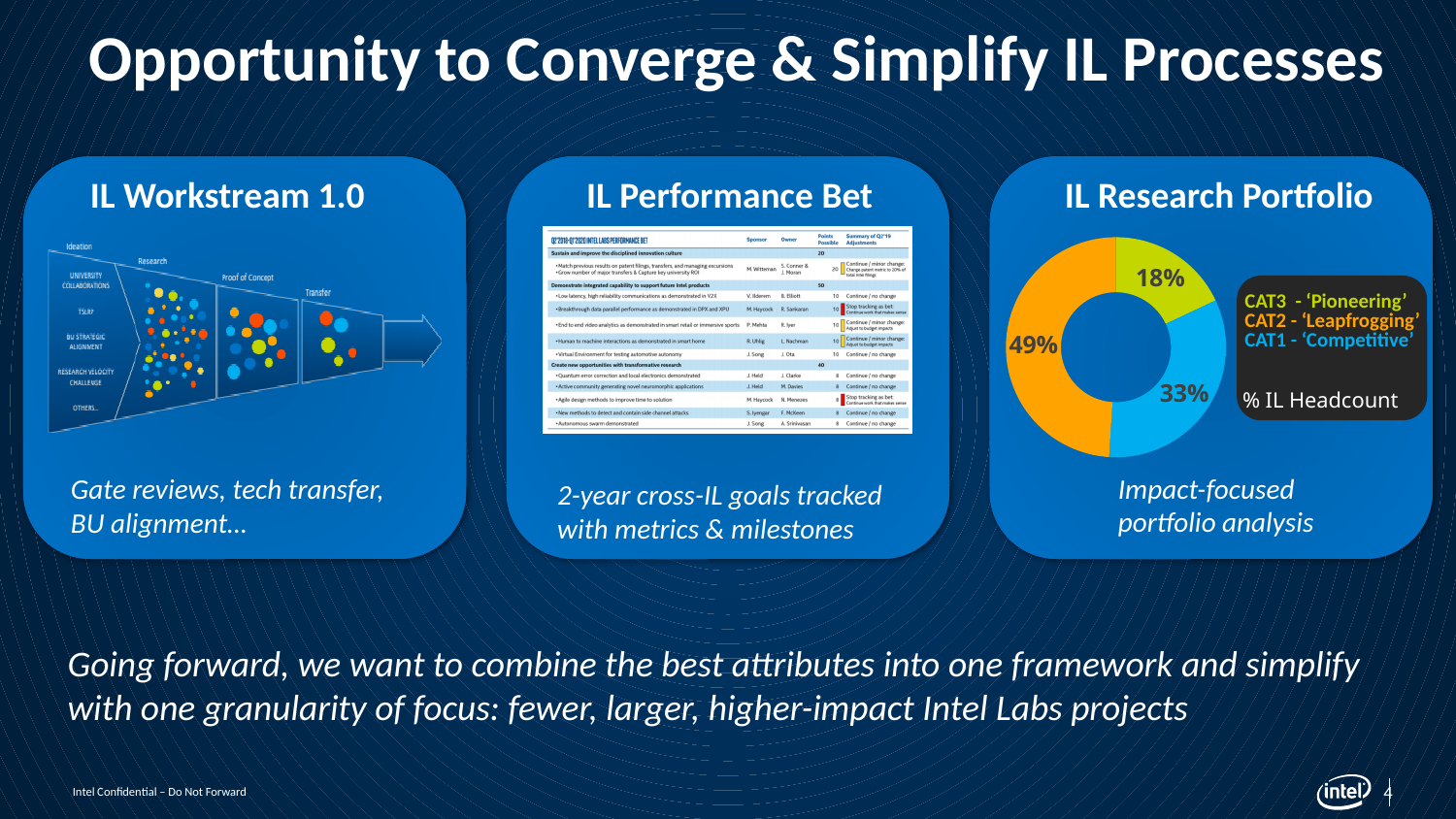
In the IL Research Portfolio donut chart, what is the difference between the 33% slice and the 18% slice? 15% In the IL Research Portfolio donut chart, which is larger: the orange slice or the blue slice? The orange slice (49%) In the IL Research Portfolio donut chart, what is the value of the largest slice? 49% How many categories does the legend of the IL Research Portfolio donut chart list? 3 What kind of chart is shown in the 'IL Research Portfolio' panel? Donut (pie) chart In the IL Research Portfolio donut chart, what is the value of the smallest slice? 18% In the IL Research Portfolio donut chart, what percentage is shown on the orange slice? 49% In the IL Research Portfolio donut chart, how many slices are there? 3 In the IL Research Portfolio donut chart, what is the difference between the largest slice (49%) and the smallest slice (18%)? 31% In the IL Research Portfolio donut chart, what percentage is shown on the green slice? 18% What metric does the IL Research Portfolio donut chart represent, according to the label next to it? % IL Headcount In the IL Research Portfolio donut chart, what percentage is shown on the blue slice? 33%